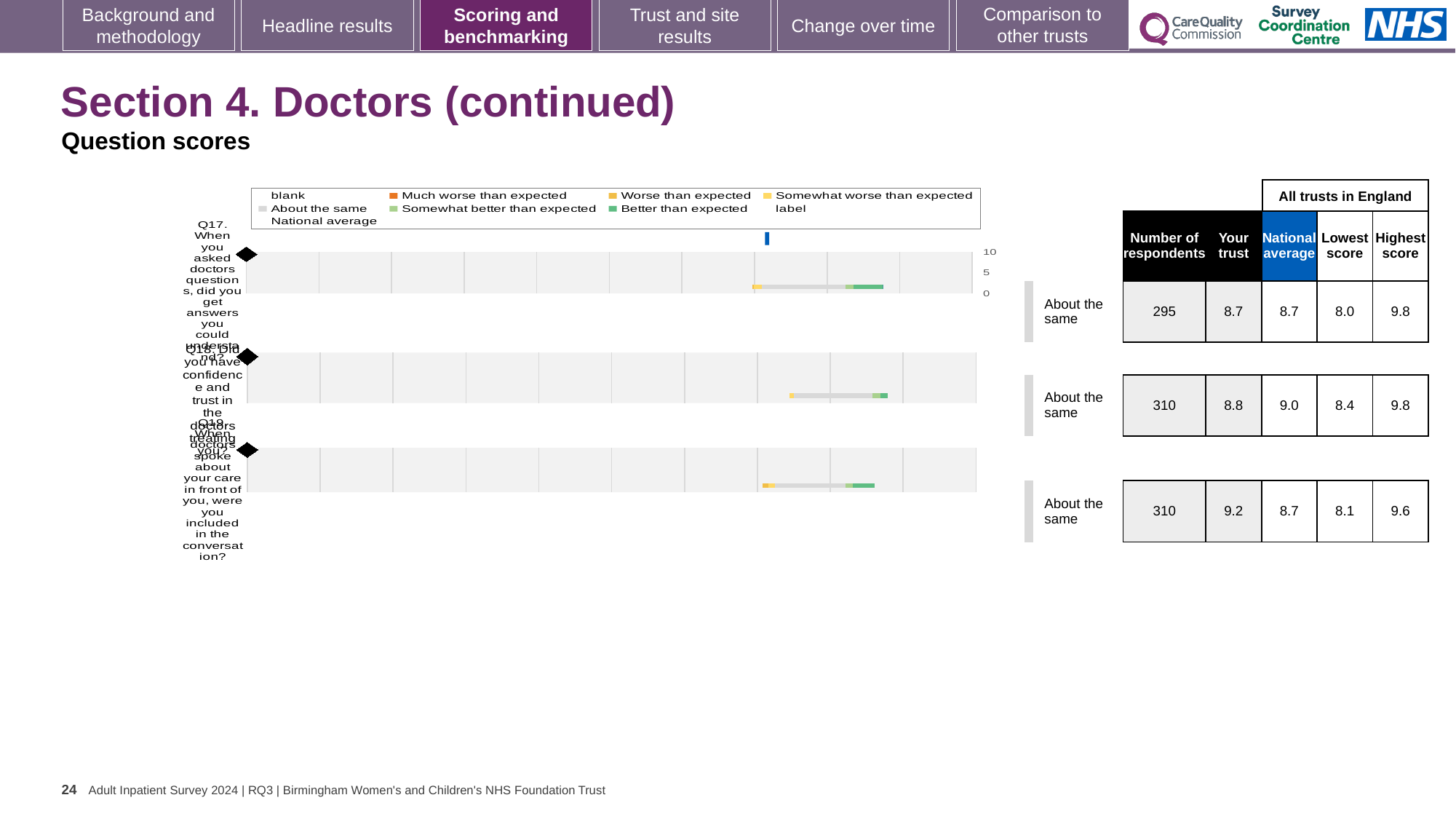
What is the highest value shown on the chart's axis? 10 What is the difference between the highest score and the lowest score for Q18 in the table beside the chart? 1.4 How many questions (categories) are plotted in the chart? 3 Which question has the highest 'Your trust' score in the table beside the chart? Q19 For Q19, which is larger: the 'Your trust' score or the national average? Your trust What is the number of respondents for Q17 in the table beside the chart? 295 Which legend entry is shown in dark orange? Much worse than expected How many entries does the chart legend list? 9 What is the national average for Q18 in the table beside the chart? 9.0 What kind of chart is shown on the slide? bar chart Which question has the lowest number of respondents in the table beside the chart? Q17 What is the 'Your trust' score for Q19 in the table beside the chart? 9.2